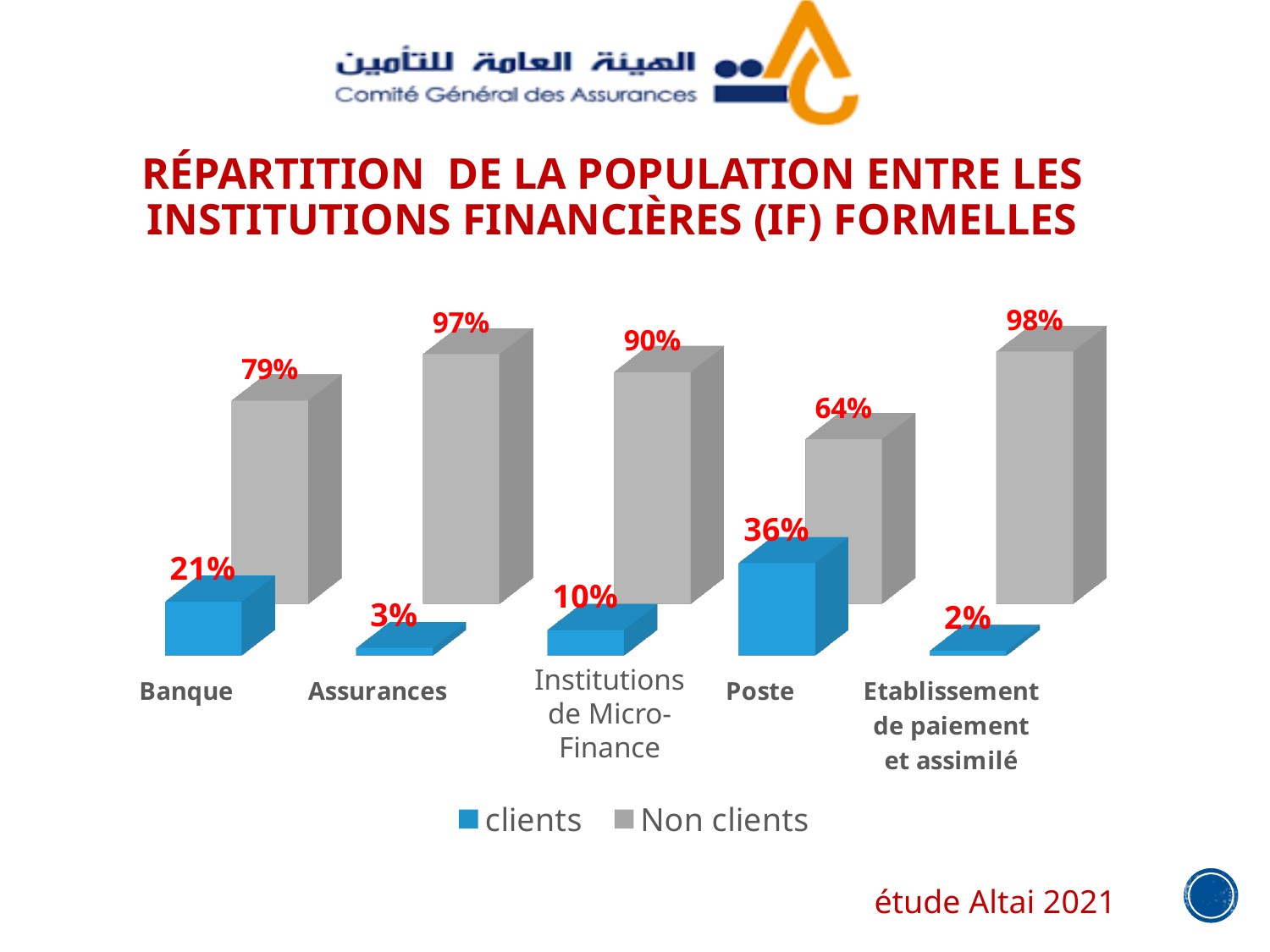
What is the difference between the Non clients value and the clients value at Poste? 28% What kind of chart is shown on the slide? Bar chart Which category has the lowest value for clients? Etablissement de paiement et assimilé Which category has the highest value for clients? Poste How many categories are shown on the x axis? 5 What is the value for Non clients at Assurances? 97% How many series does the legend list? 2 Which category has the highest value for Non clients? Etablissement de paiement et assimilé What is the value for clients at Poste? 36% Which is larger: the clients value at Banque or the clients value at Institutions de Micro-Finance? Banque What is the value for clients at Banque? 21% What is the value for Non clients at Institutions de Micro-Finance? 90%